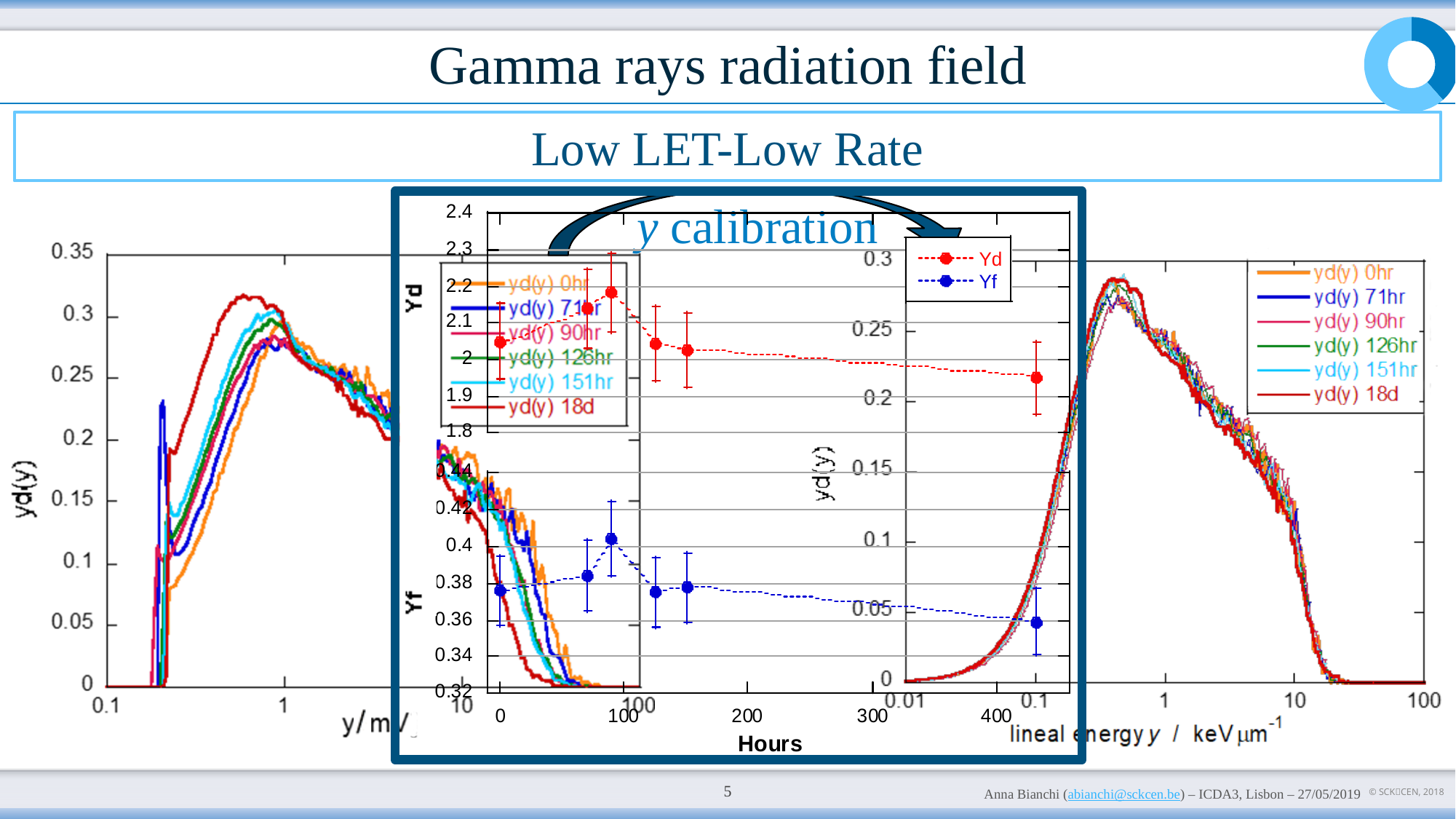
In the right chart (yd(y) versus lineal energy), is the peak of the curves greater or less than 0.3? less In the middle chart (Yd and Yf versus Hours), what are the two legend entries? Yd and Yf In the middle chart (Yd and Yf versus Hours), how many series does the legend list? 2 In the middle chart (Yd and Yf versus Hours), what is the label of the x axis? Hours In the middle chart, is the Yf value at 0 hours greater or less than 0.4? less In the middle chart, is the Yd value at 0 hours larger or smaller than the Yd value at 90 hours? smaller In the right chart (yd(y) versus lineal energy), how many series does the legend list? 6 In the middle chart, is the Yf value at the last point (around 430 hours) greater or less than 0.36? less